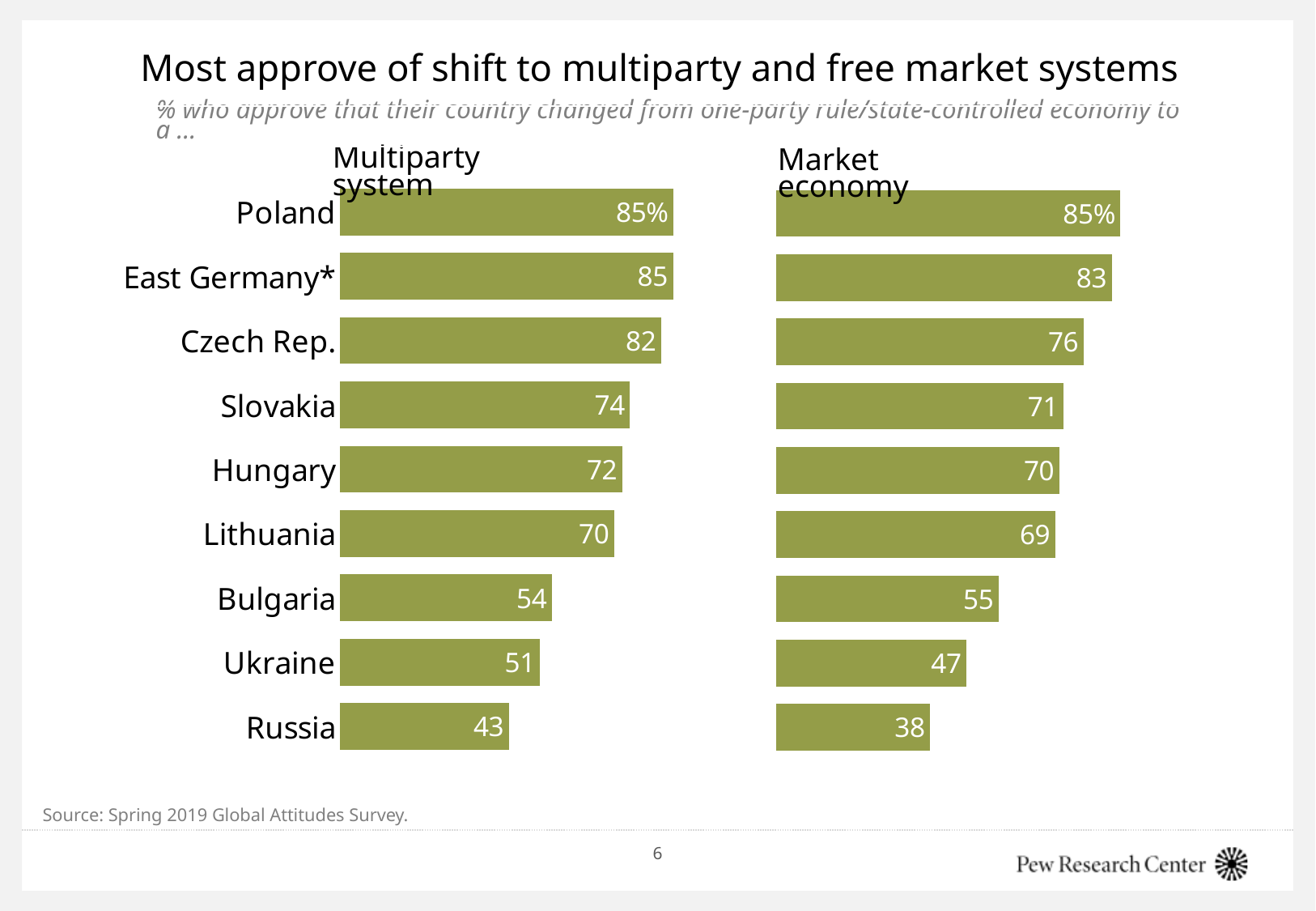
In the Multiparty system chart, which country has the lowest value? Russia In the Market economy chart, what is the value for Poland? 85% In the Multiparty system chart, do the values rise or fall from Poland down to Russia? Fall In the Market economy chart, what is the difference between East Germany* and Russia? 45 How many countries are shown in the Multiparty system chart? 9 In the Market economy chart, which country has the highest value? Poland In the Market economy chart, what is the value for Ukraine? 47 In the Multiparty system chart, what is the difference between Czech Rep. and Bulgaria? 28 What is the source cited at the bottom of the slide? Spring 2019 Global Attitudes Survey. What kind of chart is the Market economy chart? Bar chart In the Market economy chart, which is larger, Hungary or Bulgaria? Hungary In the Multiparty system chart, what is the value for Slovakia? 74